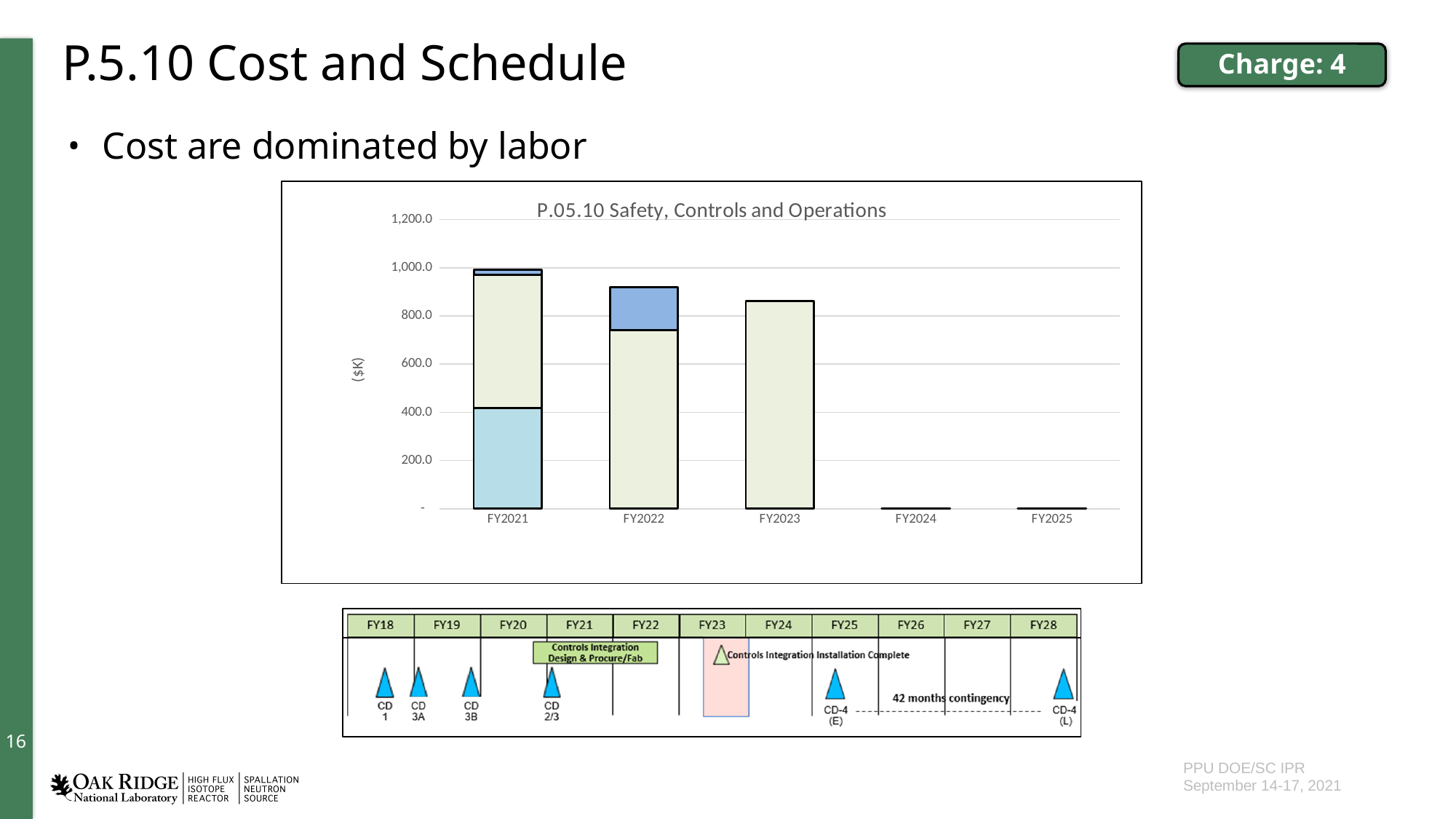
How many fiscal year categories are shown on the x axis of the chart? 5 What kind of chart is shown on the slide? Stacked bar chart Is the total value for FY2024 greater or less than 200.0? less Is the total value for FY2021 greater or less than 800.0? greater Is the total value for FY2022 greater or less than 1,000.0? less Which bar is taller, FY2021 or FY2023? FY2021 Do the bar totals rise or fall from FY2021 to FY2025? fall Which fiscal year has the tallest bar in the chart? FY2021 What is the title of the chart? P.05.10 Safety, Controls and Operations What unit is shown on the y axis of the chart? ($K)